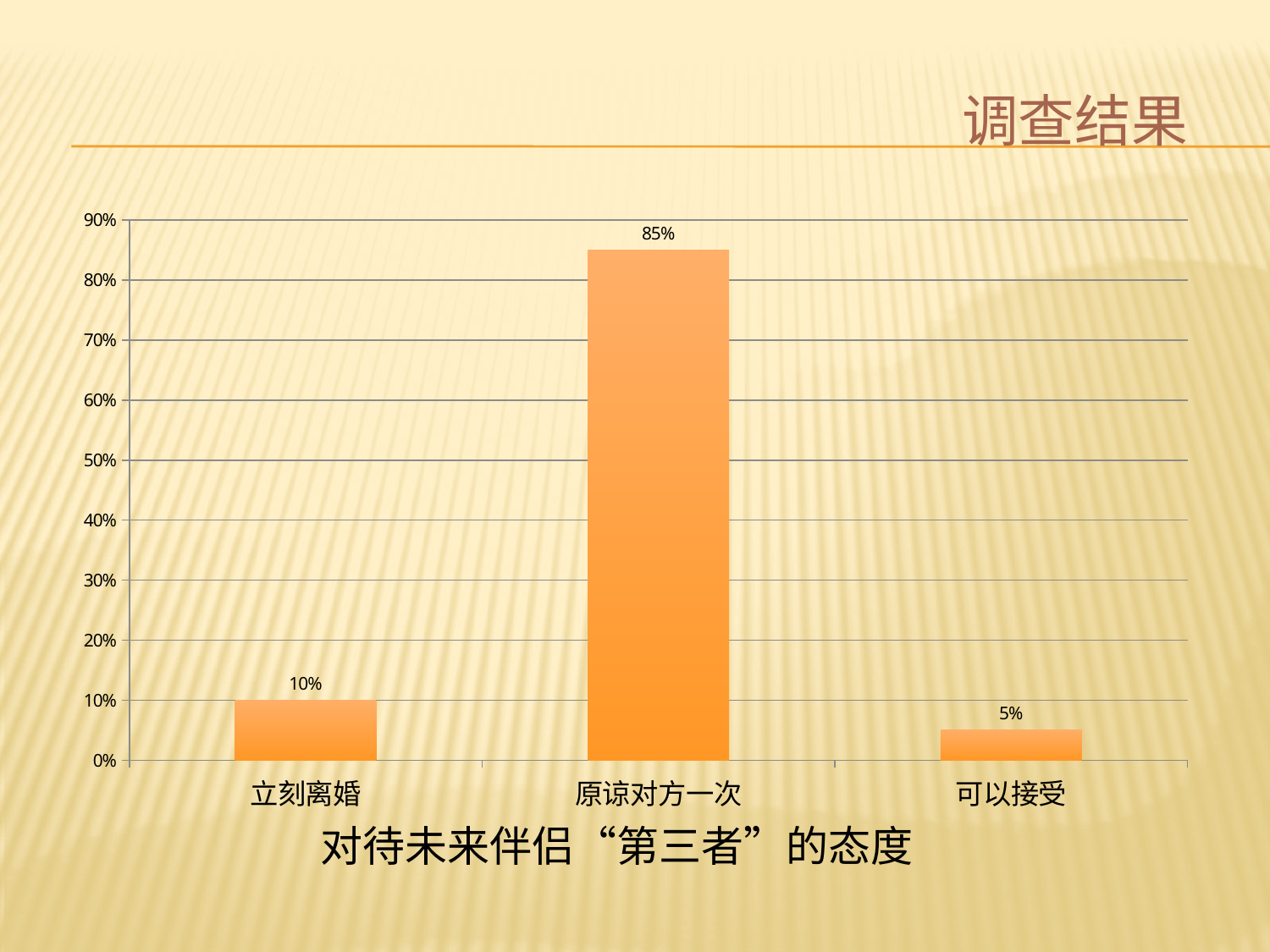
What is the difference between the values for 立刻离婚 and 可以接受? 5% Is the value for 原谅对方一次 greater or less than 80%? greater What is the difference between the values for 原谅对方一次 and 立刻离婚? 75% Which category has the lowest value? 可以接受 What is the value for 可以接受? 5% What is the title of the chart? 对待未来伴侣“第三者”的态度 What is the value for 立刻离婚? 10% What is the value for 原谅对方一次? 85% Which is larger, the value for 立刻离婚 or the value for 可以接受? 立刻离婚 What kind of chart is shown on the slide? bar chart How many categories are shown on the x axis? 3 Which category has the highest value? 原谅对方一次